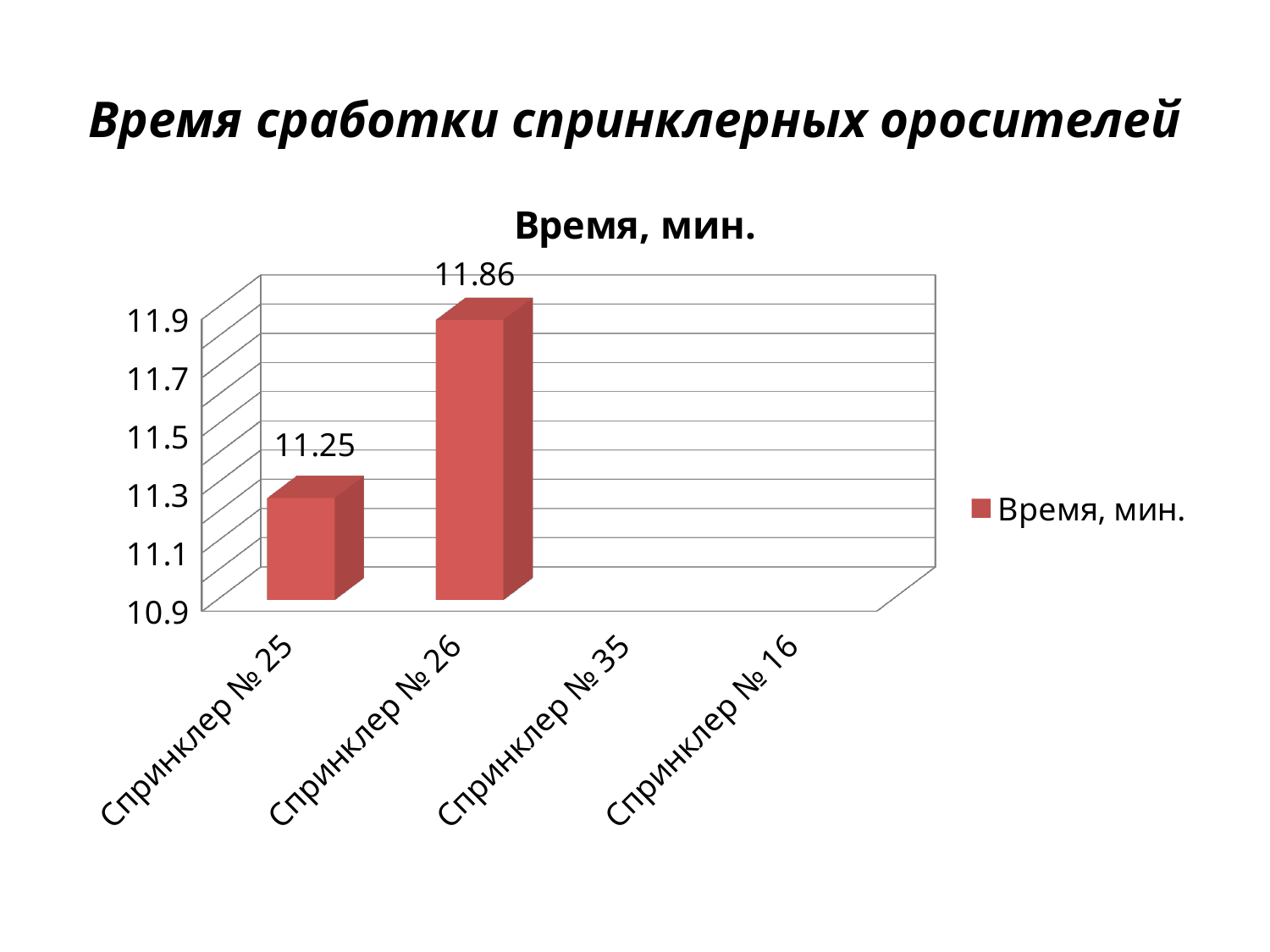
What is the title of the chart? Время, мин. How many categories are listed on the x axis? 4 What is the value for Спринклер № 25? 11.25 Which category has the highest value? Спринклер № 26 Is the value for Спринклер № 26 greater or less than 11.7? greater How many series does the legend list? 1 Which of the two plotted bars, Спринклер № 25 or Спринклер № 26, has the lower value? Спринклер № 25 What kind of chart is shown? bar chart Is the value for Спринклер № 25 greater or less than 11.5? less What is the value for Спринклер № 26? 11.86 Which is larger, the value for Спринклер № 25 or Спринклер № 26? Спринклер № 26 What is the difference between the values for Спринклер № 26 and Спринклер № 25? 0.61